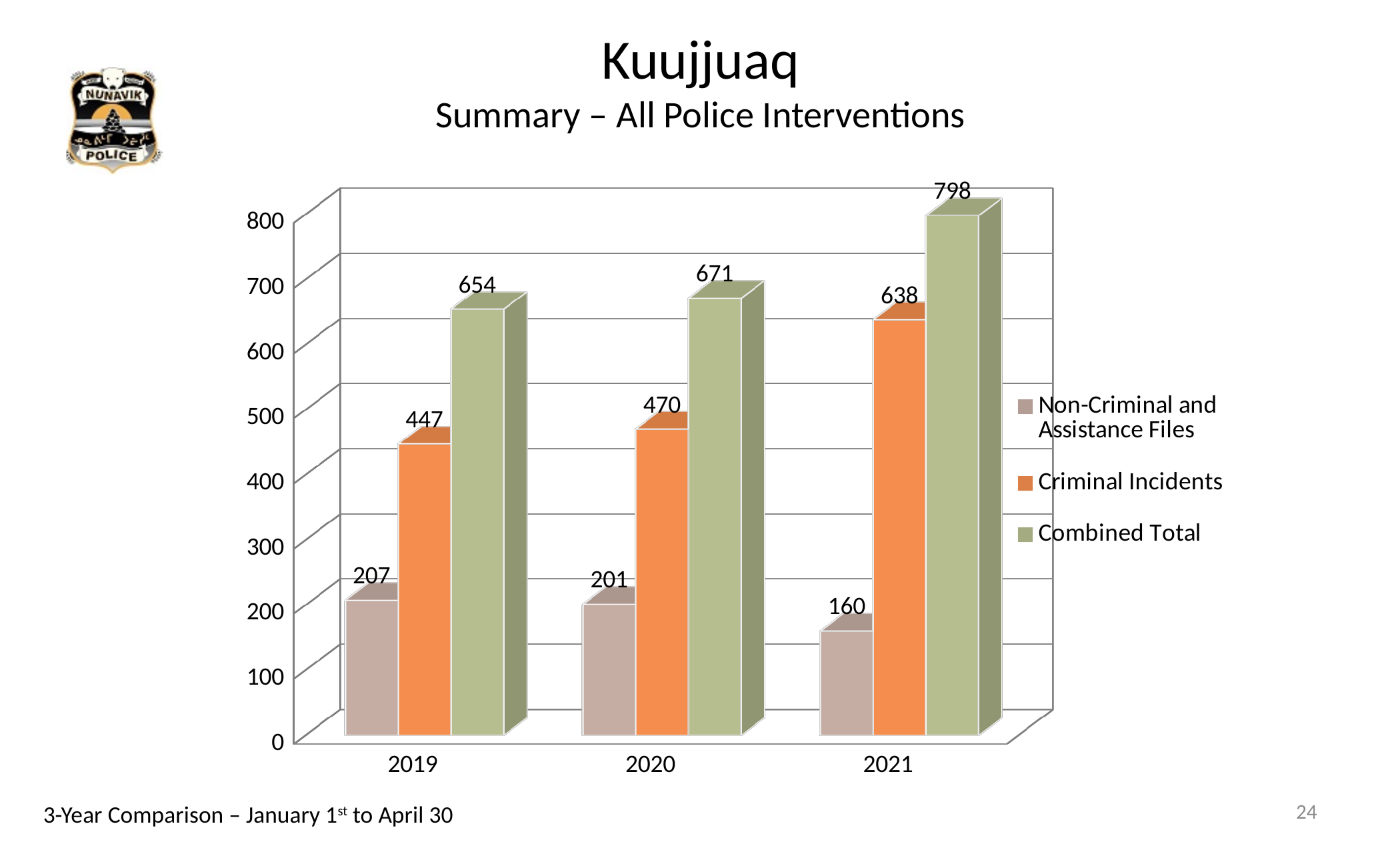
Which is larger: Criminal Incidents in 2019 or Criminal Incidents in 2020? Criminal Incidents in 2020 How many years are shown on the x axis? 3 Do the Non-Criminal and Assistance Files values rise or fall from 2019 to 2021? Fall What is the value for Non-Criminal and Assistance Files in 2019? 207 What is the value for Criminal Incidents in 2021? 638 What is the Combined Total for 2020? 671 Which year has the lowest value for Non-Criminal and Assistance Files? 2021 Which year has the highest Combined Total? 2021 What kind of chart is shown on the slide? Bar chart What is the difference between Criminal Incidents in 2021 and in 2020? 168 How many series does the legend list? 3 What is the title of the chart? Kuujjuaq Summary – All Police Interventions